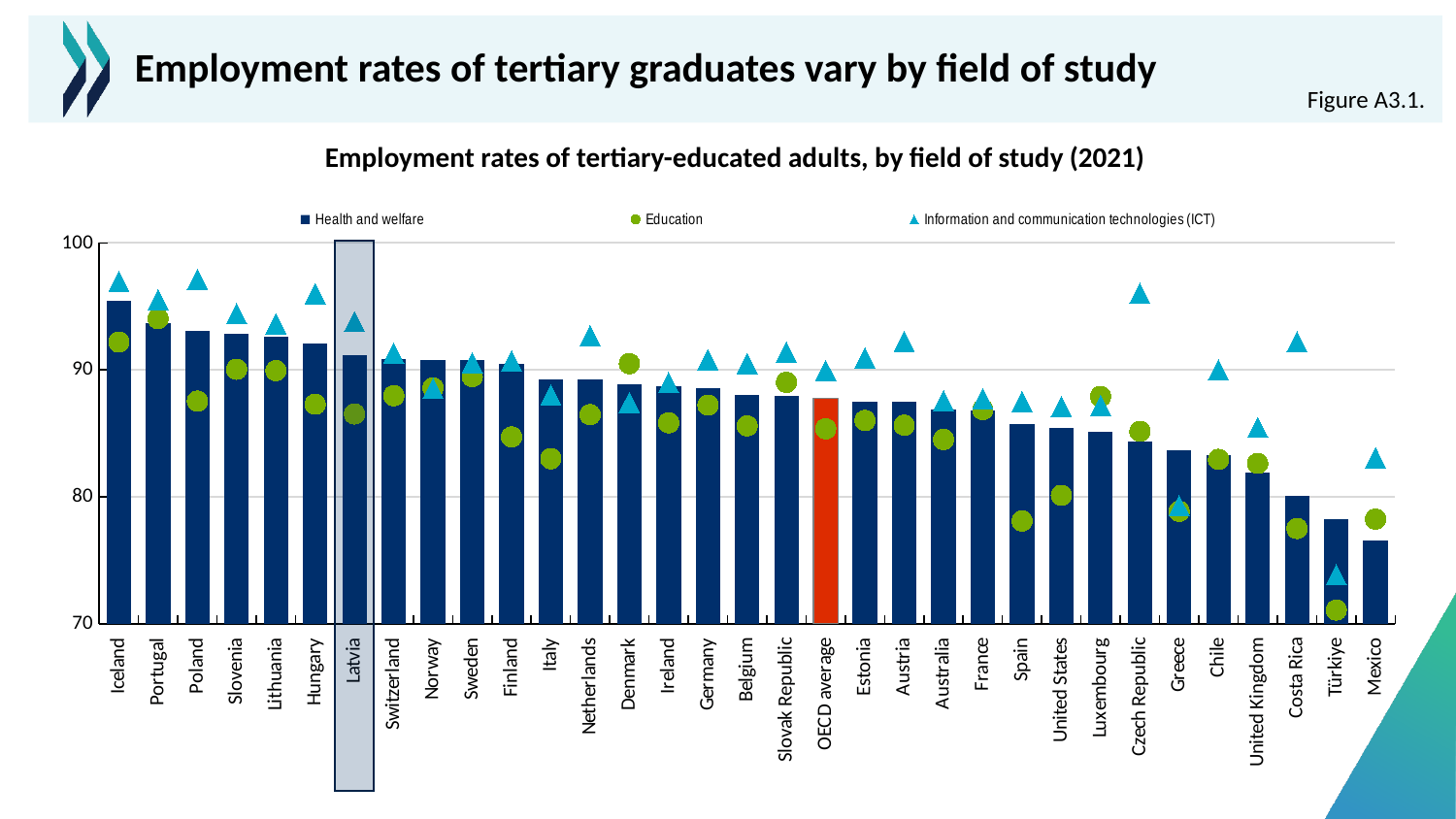
Is the Education value for Spain greater or less than 80? less Which country is highlighted with a shaded box on the chart? Latvia How many series does the legend list? 3 Is the Information and communication technologies (ICT) value for the Czech Republic greater or less than 90? greater Is the Health and welfare value for Mexico greater or less than 80? less Which country has the highest Health and welfare employment rate? Iceland Do the Health and welfare bars rise or fall from left to right along the x axis? Fall Which is larger, the Education value for Portugal or the Education value for Spain? Portugal What kind of chart is shown on the slide? Bar chart with overlaid markers How many countries/categories are shown along the x axis? 33 Which country has the lowest Health and welfare employment rate? Mexico